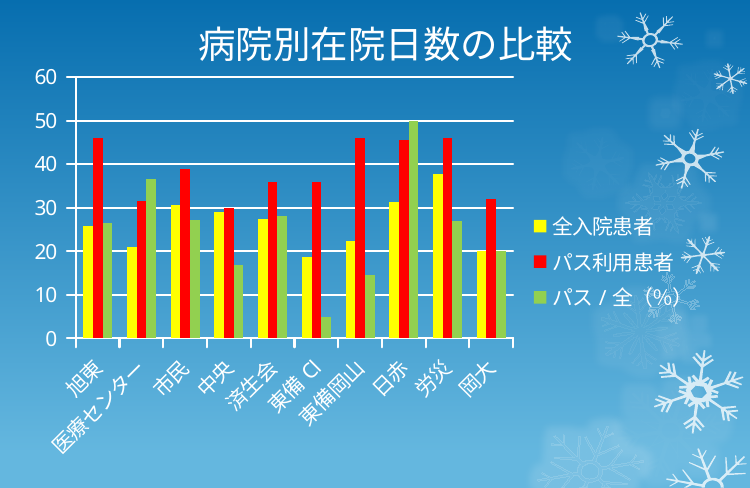
Is the value for 全入院患者 at 労災 greater or less than 30? greater At 旭東, which is larger: 全入院患者 or パス利用患者? パス利用患者 Is the value for パス利用患者 at 旭東 greater or less than 40? greater Which hospital has the highest value for 全入院患者? 労災 How many series does the legend list? 3 At 日赤, which is larger: 全入院患者 or パス / 全（%）? パス / 全（%） Which hospital has the highest value for パス / 全（%）? 日赤 Which colour represents the パス利用患者 series? red What is the title of the chart? 病院別在院日数の比較 What type of chart is shown on the slide? bar chart How many hospitals (categories) are shown on the x axis? 10 Is the value for パス / 全（%） at 東備 CI greater or less than 10? less